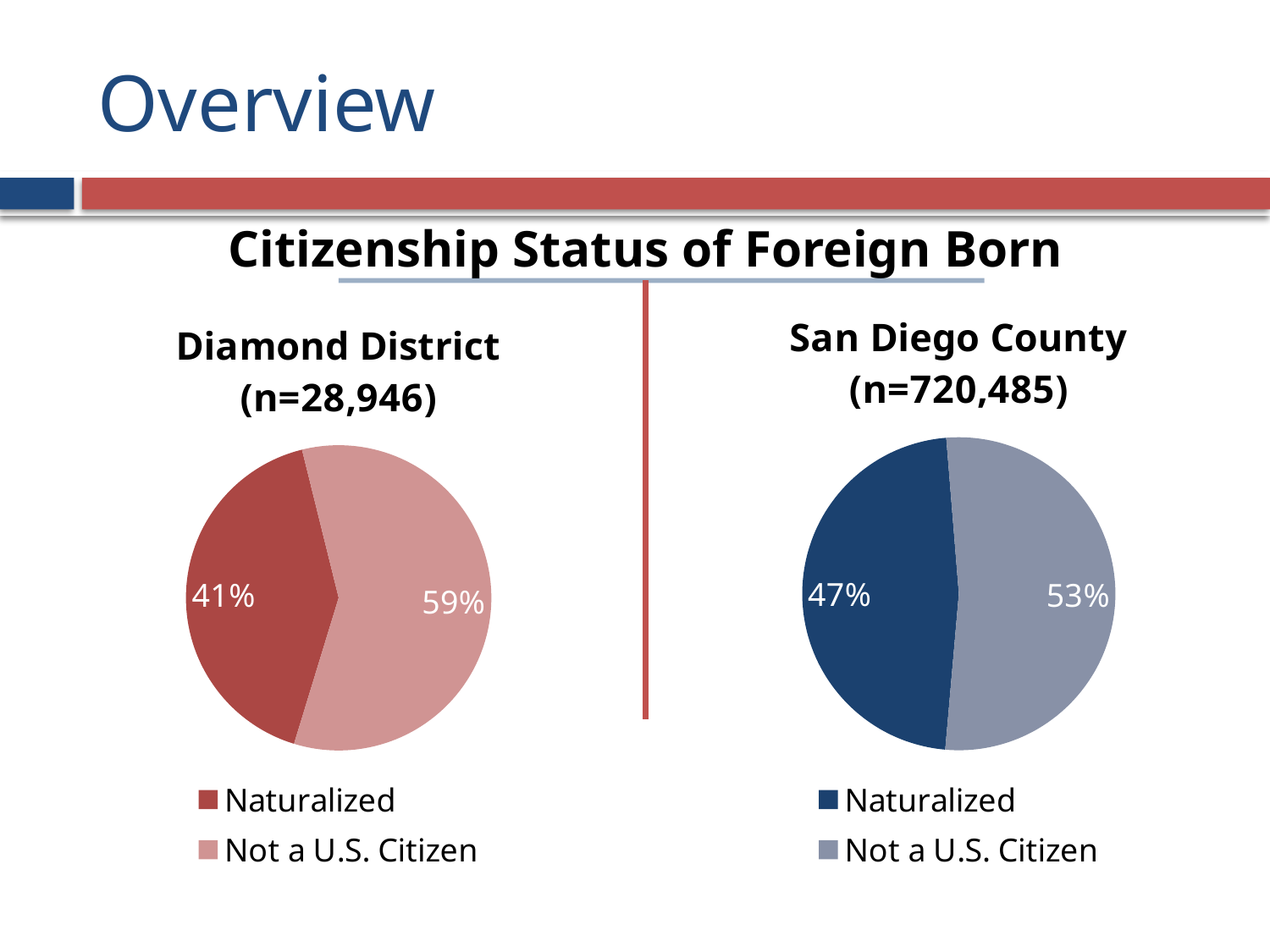
In the Diamond District pie chart, which category has the largest slice? Not a U.S. Citizen What is the sample size (n) shown for the San Diego County pie chart? 720,485 In the San Diego County pie chart, which category has the smallest slice? Naturalized In the Diamond District pie chart, what is the difference between the Not a U.S. Citizen share and the Naturalized share? 18% In the Diamond District pie chart, what share is Naturalized? 41% What kind of chart is used for the Diamond District data? Pie chart Which is larger: the Naturalized share in the Diamond District chart or the Naturalized share in the San Diego County chart? San Diego County In the Diamond District pie chart, what share is Not a U.S. Citizen? 59% How many slices does the San Diego County pie chart have? 2 In the San Diego County pie chart, what share is Not a U.S. Citizen? 53% In the San Diego County pie chart, what share is Naturalized? 47% How many entries does the legend of the Diamond District pie chart list? 2